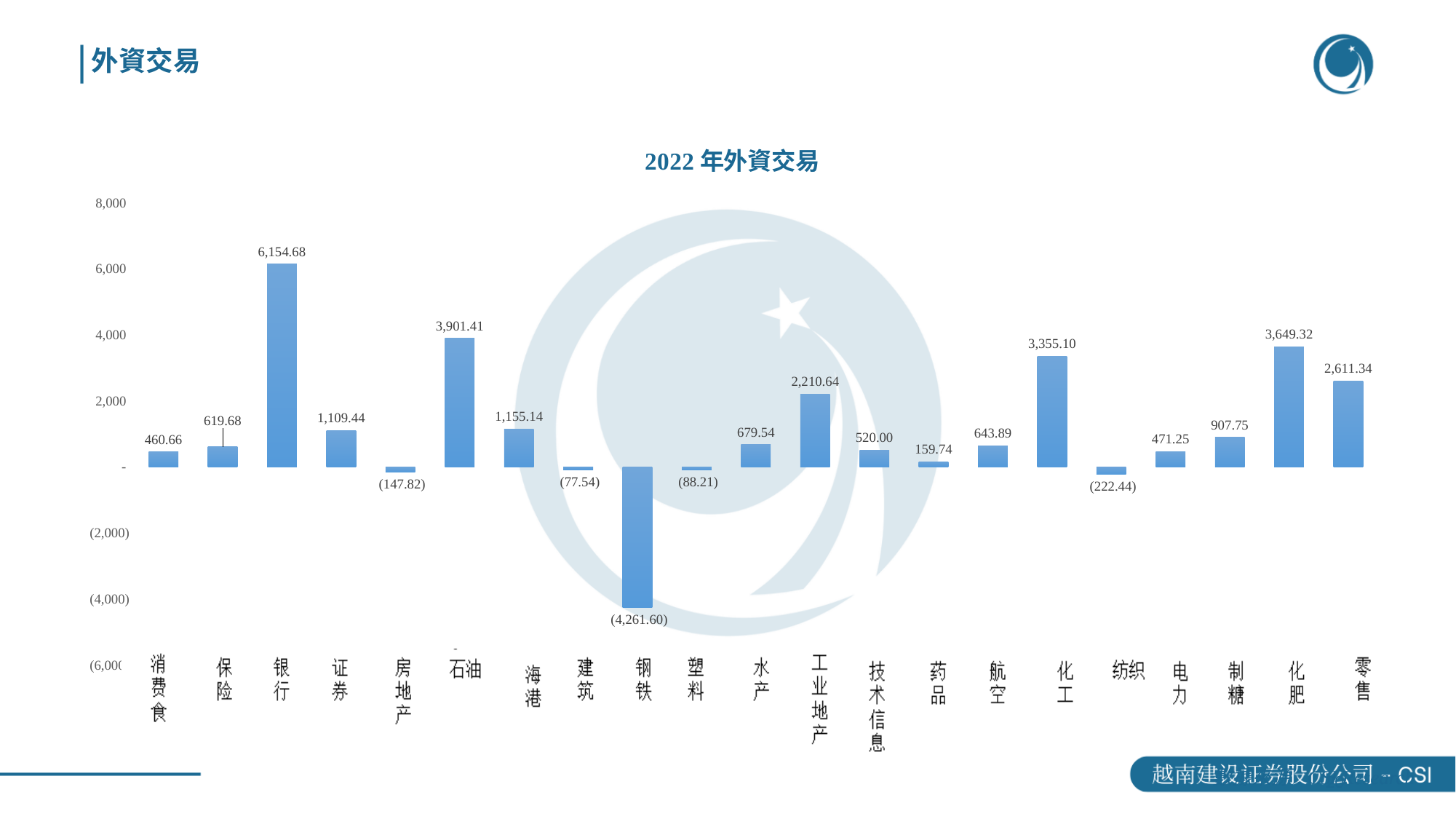
What is the value for 化肥? 3,649.32 What is the title of the chart? 2022 年外資交易 What is the value for 纺织? (222.44) What is the value for 钢铁? (4,261.60) Which category has the highest value? 银行 What is the difference between the values for 化肥 and 化工? 294.22 What is the value for 银行? 6,154.68 What is the difference between the values for 银行 and 石油? 2,253.27 Which category has the lowest value? 钢铁 What kind of chart is shown on the slide? bar chart How many categories are plotted in the chart? 21 Which is larger, the value for 化工 or the value for 零售? 化工